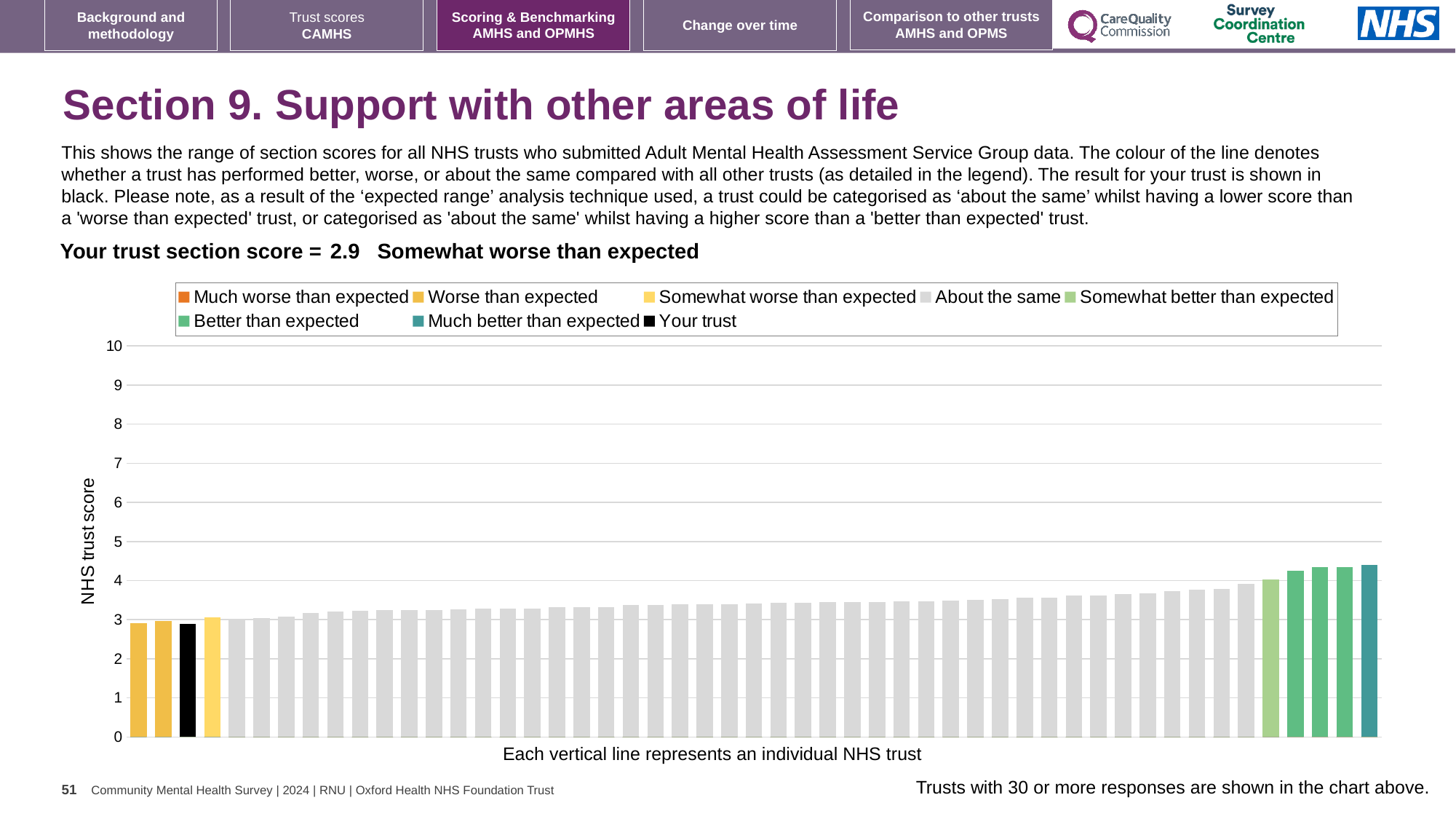
How many entries does the chart legend list? 8 Is the value of the black 'Your trust' bar greater or less than 5? less Which is larger: the value of the black 'Your trust' bar or the value of the rightmost bar? the rightmost bar Do the bar values rise or fall from left to right across the chart? rise What is the label on the vertical axis of the chart? NHS trust score Is the value of the tallest bar in the chart greater or less than 4? greater How many bars are coloured as 'Better than expected'? 3 How many bars are coloured as 'Worse than expected'? 2 What kind of chart is shown on the slide? bar chart Which legend category does your trust's score fall into? Somewhat worse than expected Which legend category does the tallest bar in the chart belong to? Much better than expected What is the section score for your trust shown on the slide? 2.9